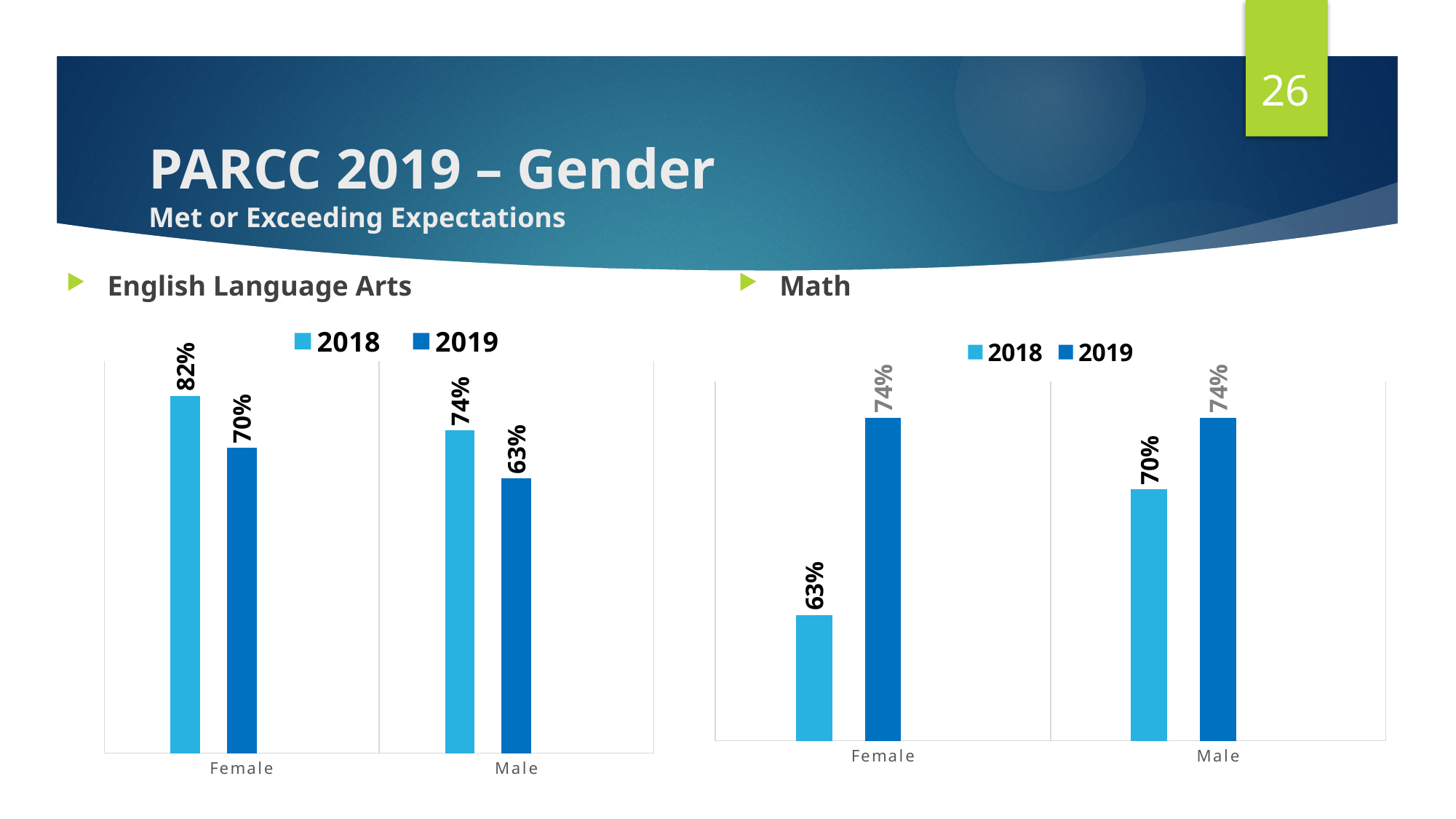
What kind of chart is the Math chart? Bar chart In the English Language Arts chart, what is the value for Male in 2019? 63% In the Math chart, what is the difference between the Female 2019 and Female 2018 values? 11% In the Math chart, what is the value for Male in 2019? 74% In the English Language Arts chart, what is the value for Female in 2018? 82% In the English Language Arts chart, which category has the highest 2018 value? Female In the Math chart, which is larger for Male: the 2018 value or the 2019 value? 2019 In the English Language Arts chart, what is the difference between the Female 2018 and Female 2019 values? 12% How many series does the legend of the English Language Arts chart list? 2 In the Math chart, which category has the lowest 2018 value? Female How many categories are shown on the x axis of the Math chart? 2 In the Math chart, what is the value for Female in 2018? 63%